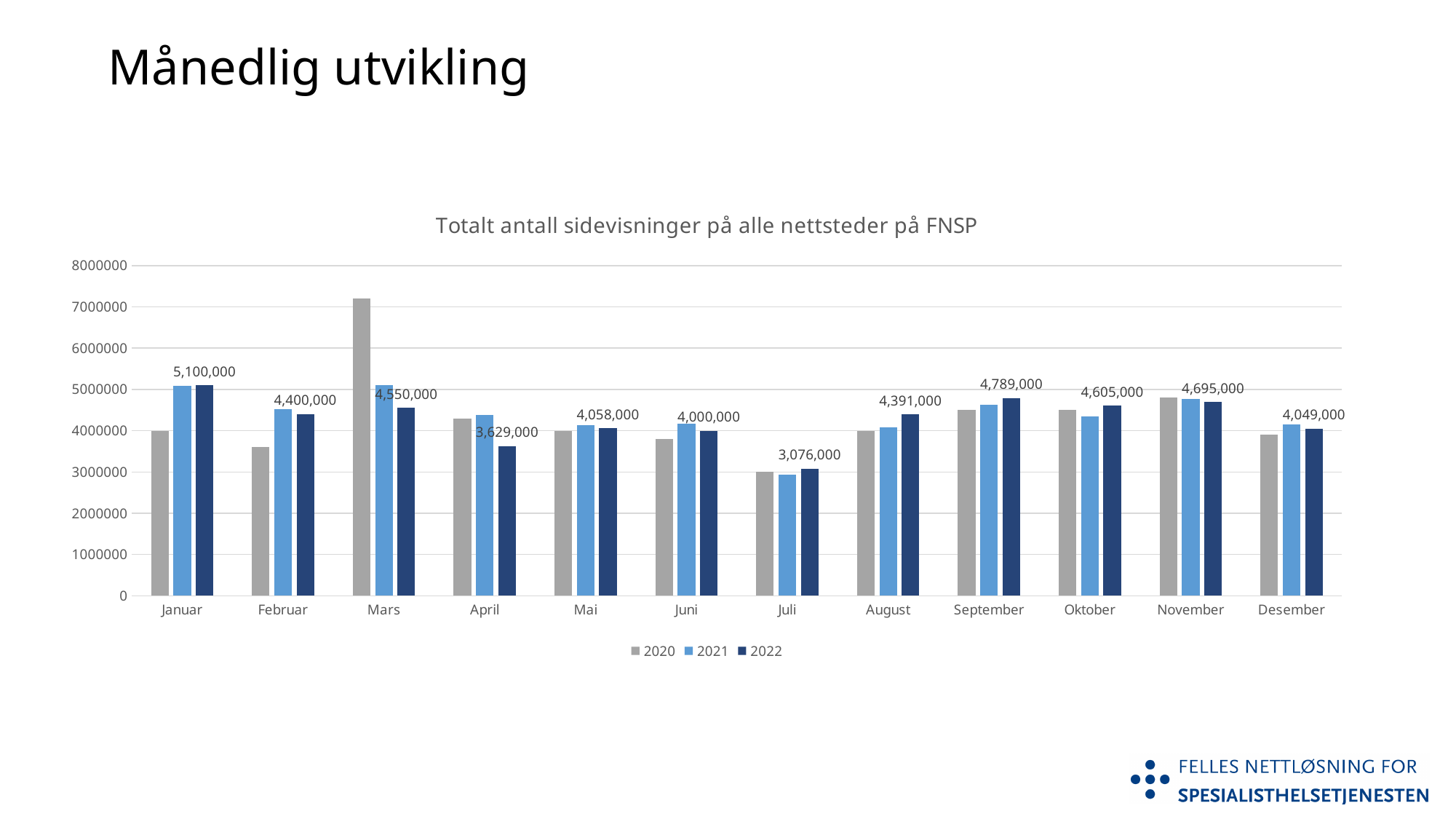
What is the 2022 value for Juli? 3,076,000 How many months are shown on the x axis? 12 What kind of chart is shown on the slide? Bar chart Which month has the lowest 2022 value? Juli Which is larger for 2022: Oktober or November? November What is the title of the chart? Totalt antall sidevisninger på alle nettsteder på FNSP Is the 2020 value for Mars greater or less than 7000000? greater What is the 2022 value for Januar? 5,100,000 What is the 2022 value for September? 4,789,000 How many series does the legend list? 3 Which month has the highest 2022 value? Januar What is the difference between the 2022 values for Januar and Juli? 2,024,000